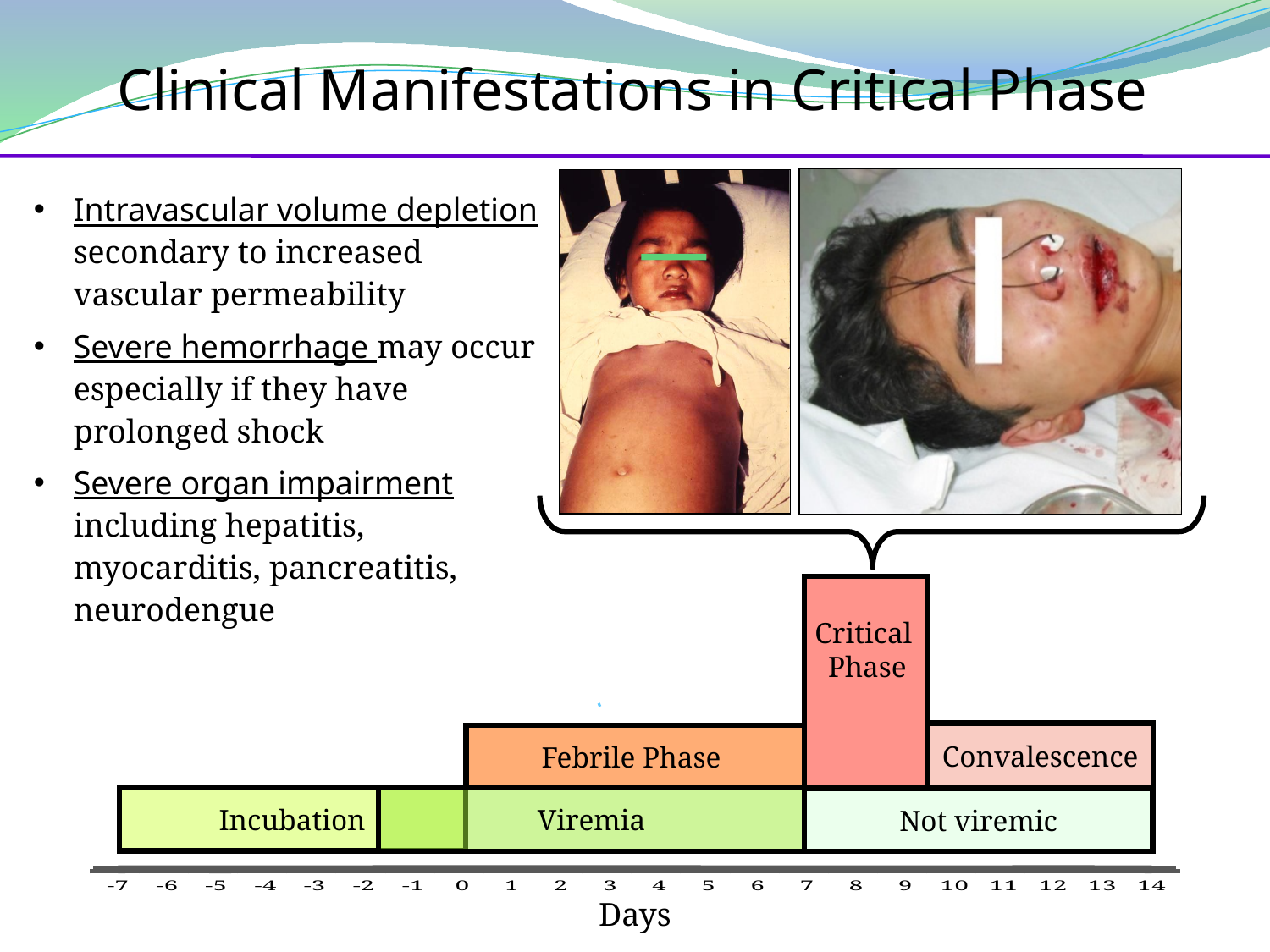
Which phase block on the timeline is the tallest? Critical Phase What is the label of the horizontal axis on the timeline chart? Days Which block in the bottom row of the timeline covers days 7 to 14? Not viremic How many labeled phase blocks are shown on the timeline? 6 What is the highest day value shown on the timeline axis? 14 Does the Critical Phase block begin before or after day 5 on the timeline? after Which block spans more days on the timeline, Incubation or Viremia? Viremia Which block spans more days on the timeline, Febrile Phase or Critical Phase? Febrile Phase What is the lowest day value shown on the timeline axis? -7 Which block in the upper row of the timeline covers days 0 to 7? Febrile Phase Which phase block on the timeline comes immediately after the Critical Phase? Convalescence